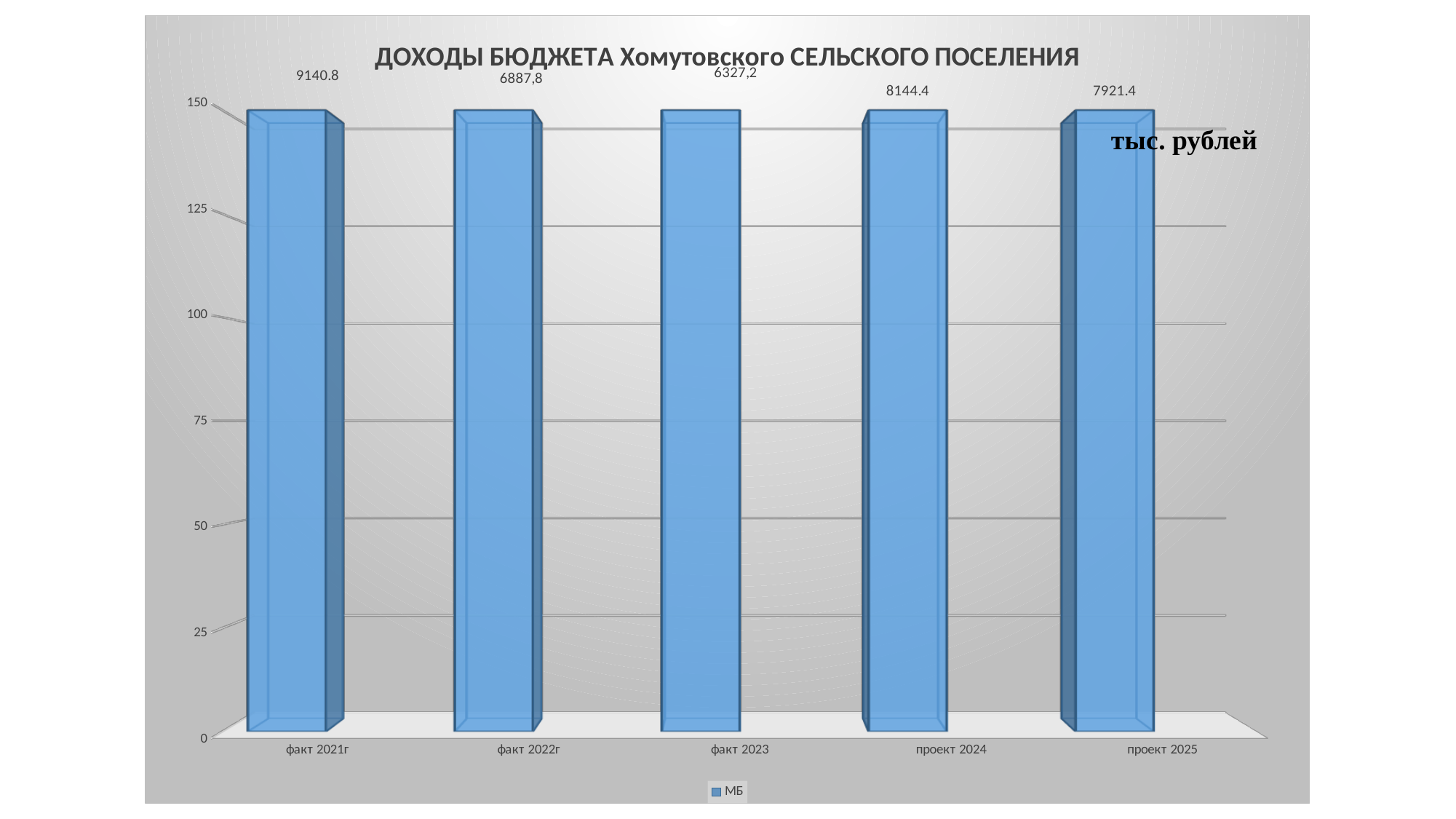
What is the title of the chart? ДОХОДЫ БЮДЖЕТА Хомутовского СЕЛЬСКОГО ПОСЕЛЕНИЯ Which category has the lowest labelled value? факт 2023 What is the value for факт 2023? 6327,2 Which category has the highest labelled value? факт 2021г How many categories are shown on the x axis? 5 What is the value for факт 2022г? 6887,8 How many series does the legend list? 1 What is the value for факт 2021г? 9140.8 What is the difference between the values for факт 2021г and проект 2024? 996.4 Which is larger, the value for проект 2024 or проект 2025? проект 2024 What is the value for проект 2025? 7921.4 What is the value for проект 2024? 8144.4